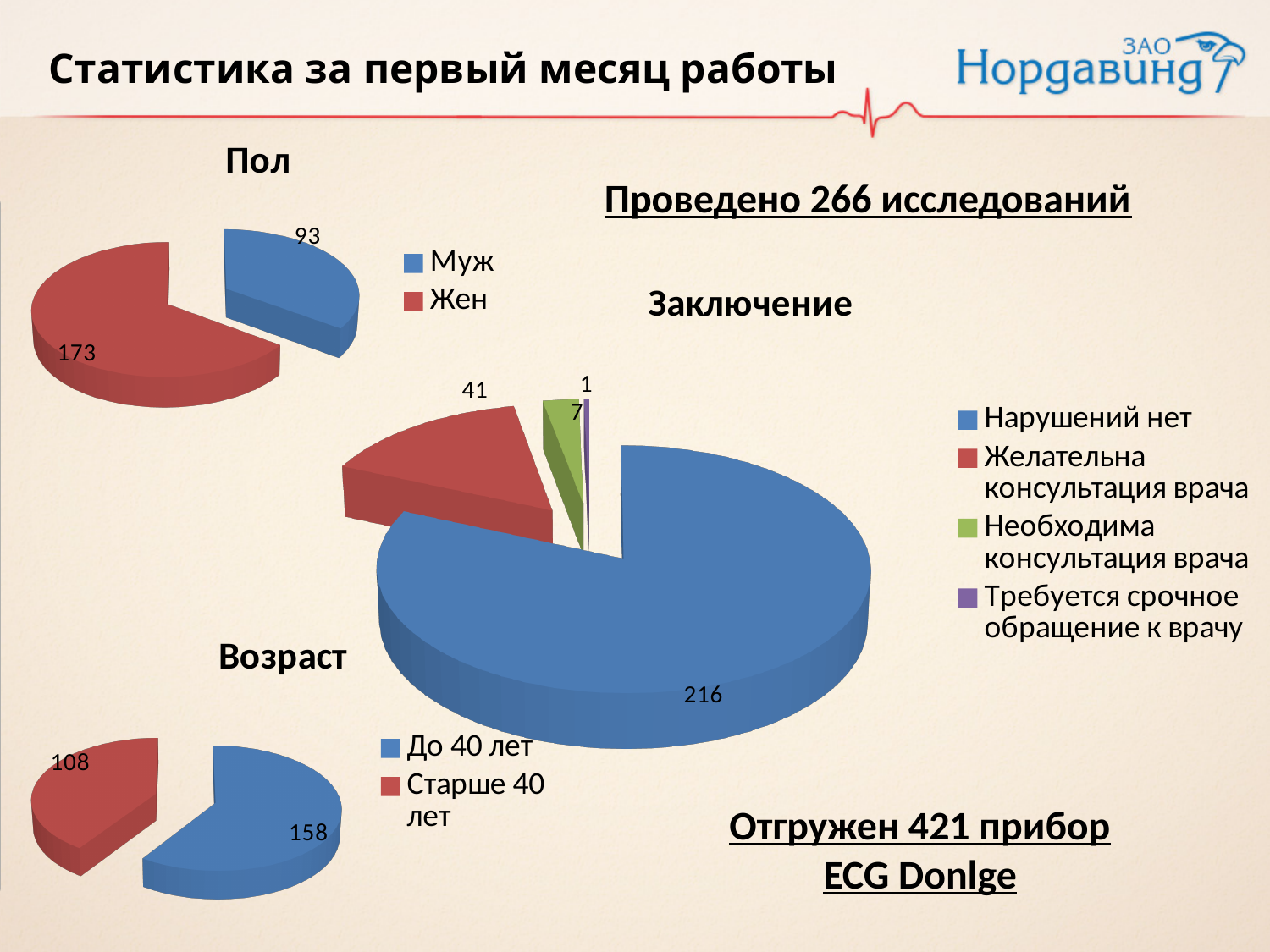
In the "Заключение" chart, what is the value for Нарушений нет? 216 In the "Пол" chart, what is the value for Жен? 173 What type of chart is the "Возраст" chart? Pie chart In the "Пол" chart, what is the value for Муж? 93 In the "Возраст" chart, what is the value for До 40 лет? 158 In the "Заключение" chart, which category has the lowest value? Требуется срочное обращение к врачу In the "Пол" chart, what share of the total does Муж represent? 35% In the "Возраст" chart, which category is larger, До 40 лет or Старше 40 лет? До 40 лет In the "Заключение" chart, what is the value for Желательна консультация врача? 41 How many categories does the legend of the "Заключение" chart list? 4 In the "Пол" chart, what is the difference between Жен and Муж? 80 In the "Возраст" chart, what is the difference between До 40 лет and Старше 40 лет? 50